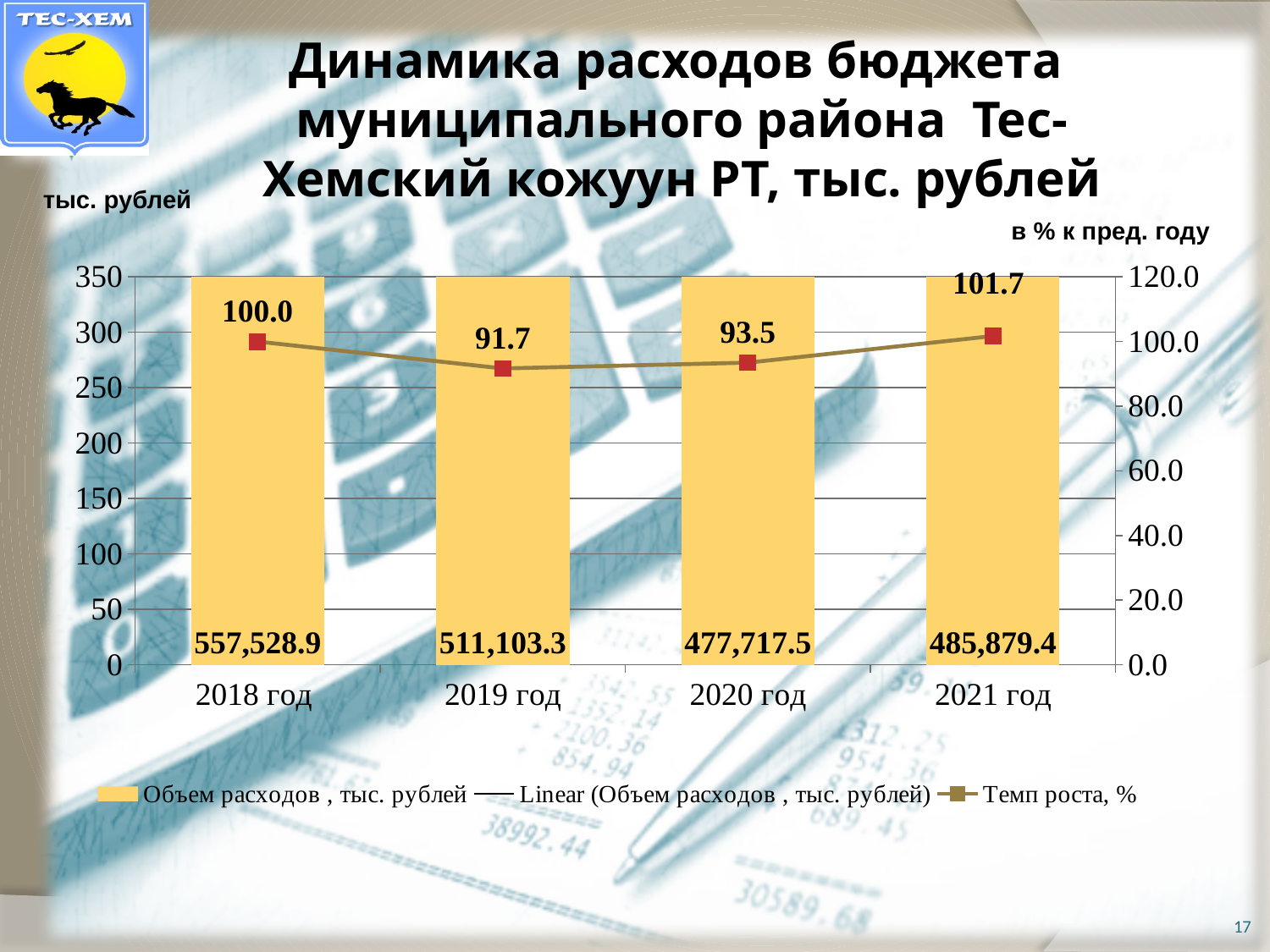
Which year has the lowest Темп роста, %? 2019 год What is the difference between the Объем расходов values for 2018 год and 2019 год? 46,425.6 What is the Темп роста, % value for 2021 год? 101.7 What is the value of Объем расходов for 2018 год? 557,528.9 Which year has the highest Объем расходов? 2018 год What is the Темп роста, % value for 2019 год? 91.7 What is the value of Объем расходов for 2020 год? 477,717.5 Which is larger, the Объем расходов for 2020 год or for 2021 год? 2021 год How many years are shown on the x axis? 4 What is the label of the right-hand vertical axis? в % к пред. году How many entries does the legend list? 3 What kind of chart is this? Combined bar and line chart